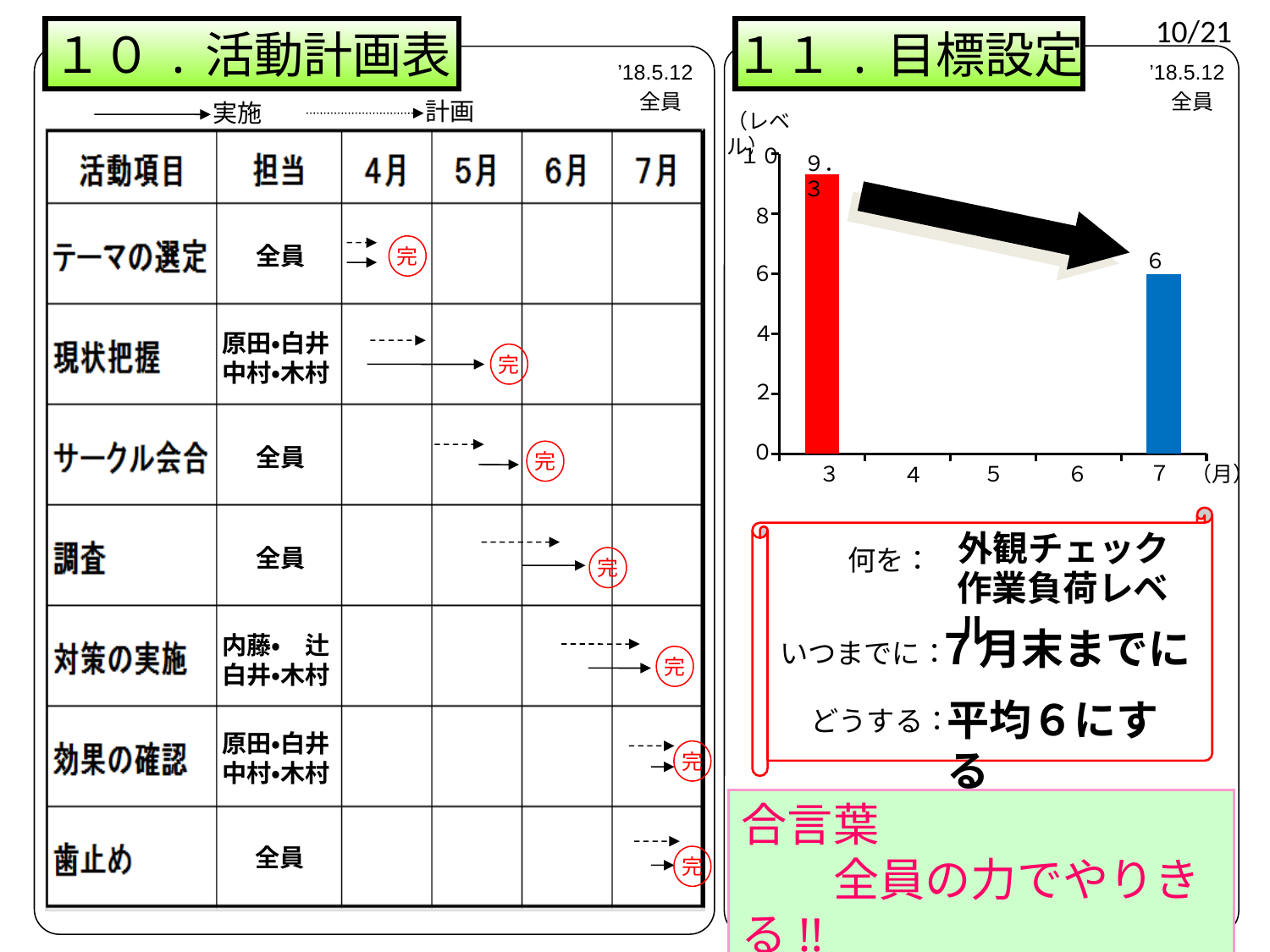
In the bar chart under 11. 目標設定, which month has the lowest bar? 7 In the bar chart under 11. 目標設定, is the value for month 7 greater or less than 8? less In the bar chart under 11. 目標設定, which is larger, the value for month 3 or the value for month 7? month 3 How many bars are plotted in the bar chart under 11. 目標設定? 2 In the bar chart under 11. 目標設定, what is the difference between the values for month 3 and month 7? 3.3 In the bar chart under 11. 目標設定, what colour is the bar for month 3? red In the bar chart under 11. 目標設定, do the values rise or fall from month 3 to month 7? fall In the bar chart under 11. 目標設定, which month has the highest bar? 3 In the bar chart under 11. 目標設定, what is the value for month 7? 6 What kind of chart is shown under 11. 目標設定? bar chart In the bar chart under 11. 目標設定, is the value for month 3 greater or less than 8? greater In the bar chart under 11. 目標設定, what is the value for month 3? 9.3